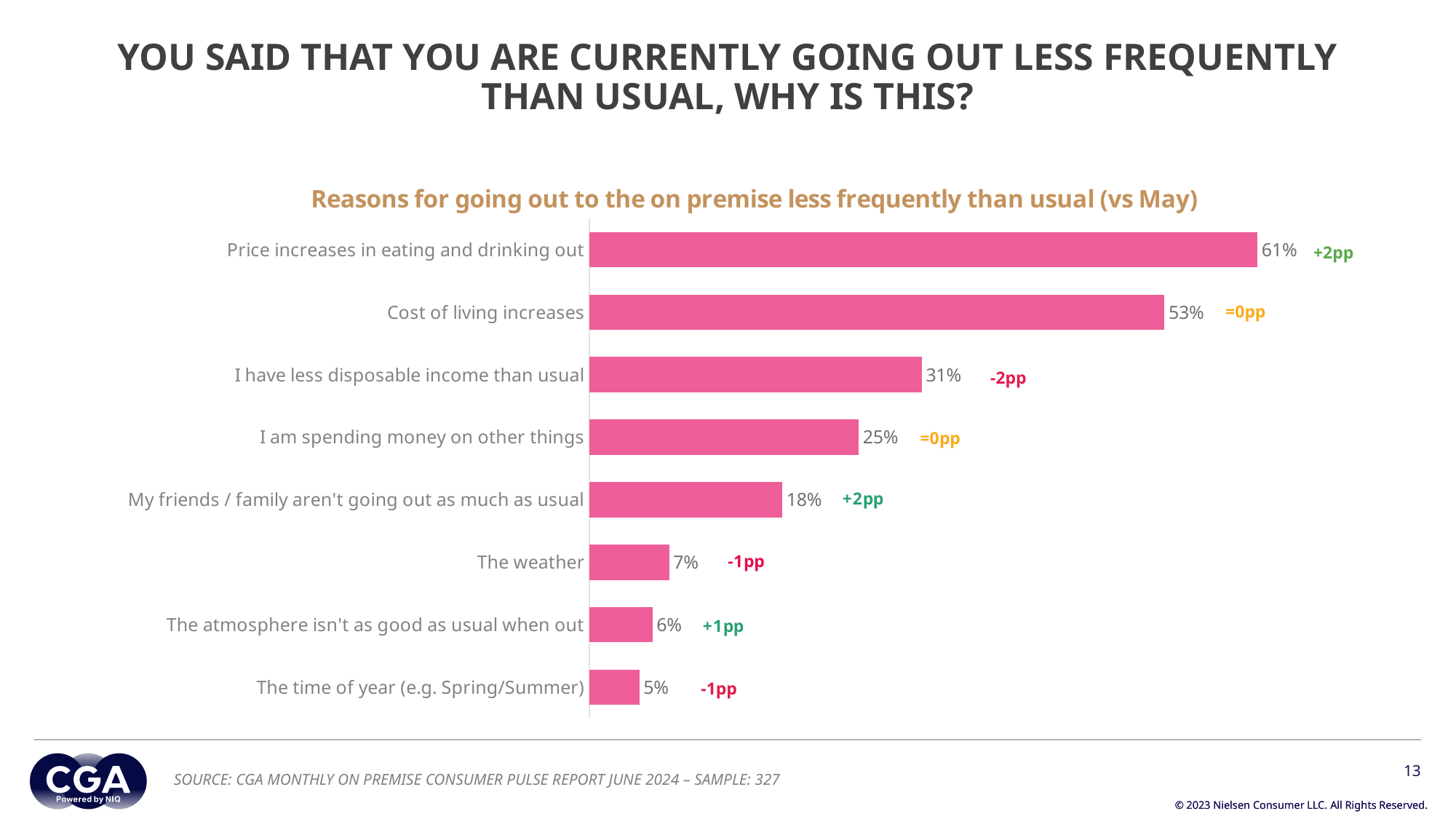
What is the title of the chart? Reasons for going out to the on premise less frequently than usual (vs May) Which is larger: the value for "My friends / family aren't going out as much as usual" or the value for "The weather"? My friends / family aren't going out as much as usual What is the change versus May shown next to "I have less disposable income than usual"? -2pp Which reason has the highest percentage in the chart? Price increases in eating and drinking out What is the difference in percentage points between "Price increases in eating and drinking out" and "Cost of living increases"? 8 percentage points How many reasons (categories) are shown in the chart? 8 What is the difference between "I have less disposable income than usual" and "I am spending money on other things"? 6 percentage points Which reason has the lowest percentage in the chart? The time of year (e.g. Spring/Summer) What percentage is shown for "The weather"? 7% What kind of chart is shown on the slide? Bar chart What is the value shown for "Cost of living increases"? 53% What percentage of respondents cited "Price increases in eating and drinking out" as a reason for going out less frequently? 61%